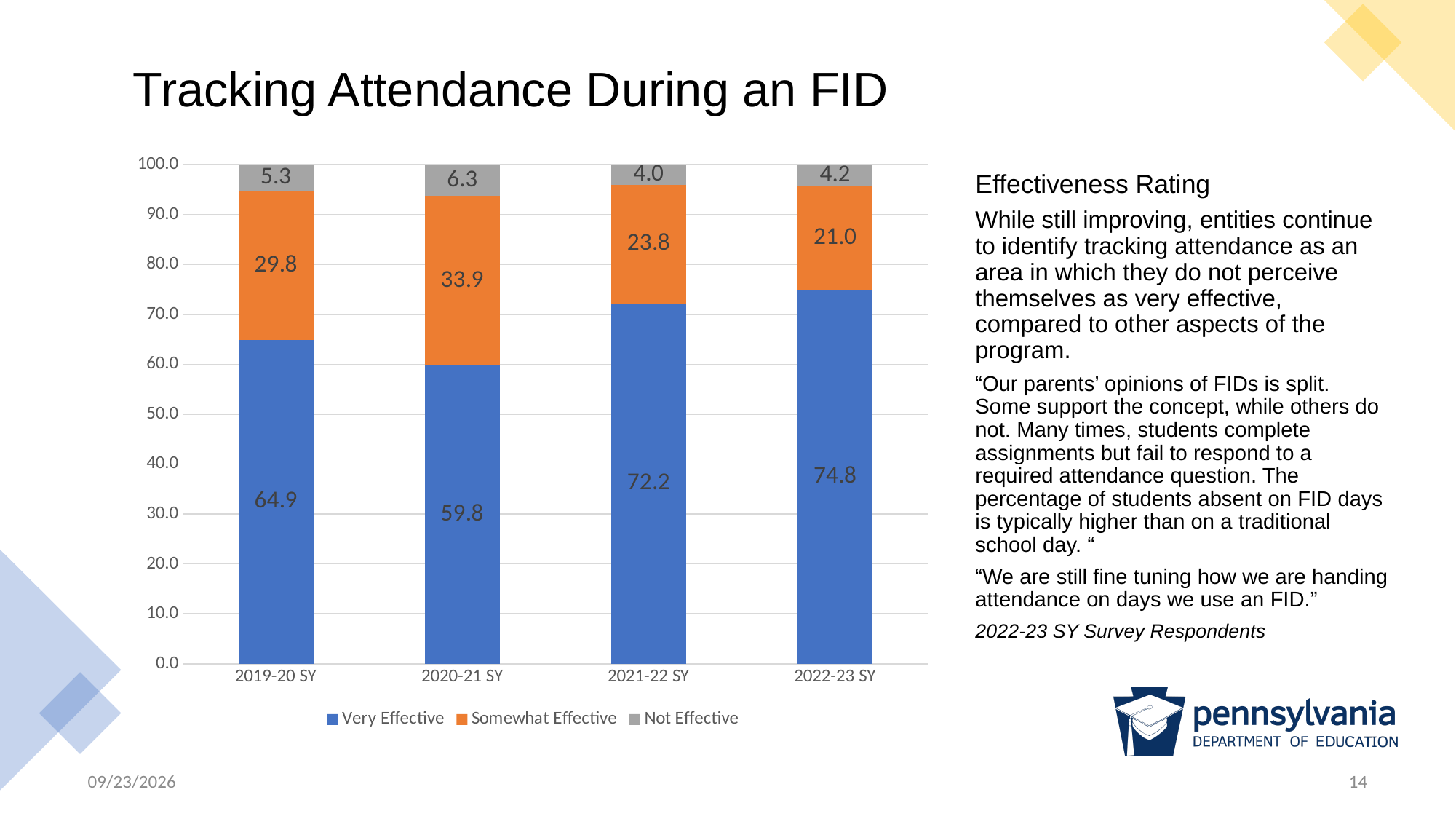
Which school year has the highest Very Effective value? 2022-23 SY What is the difference between the Very Effective values for 2022-23 SY and 2019-20 SY? 9.9 What kind of chart is shown on the slide? Stacked bar chart What is the Not Effective value for 2019-20 SY? 5.3 How many series does the legend list? 3 How many school years are shown on the x axis? 4 What is the Very Effective value for 2022-23 SY? 74.8 Which is larger, the Somewhat Effective value for 2020-21 SY or for 2022-23 SY? 2020-21 SY Which school year has the lowest Not Effective value? 2021-22 SY What is the Somewhat Effective value for 2020-21 SY? 33.9 Does the Very Effective value rise or fall from 2020-21 SY to 2022-23 SY? Rise Which school year has the lowest Very Effective value? 2020-21 SY